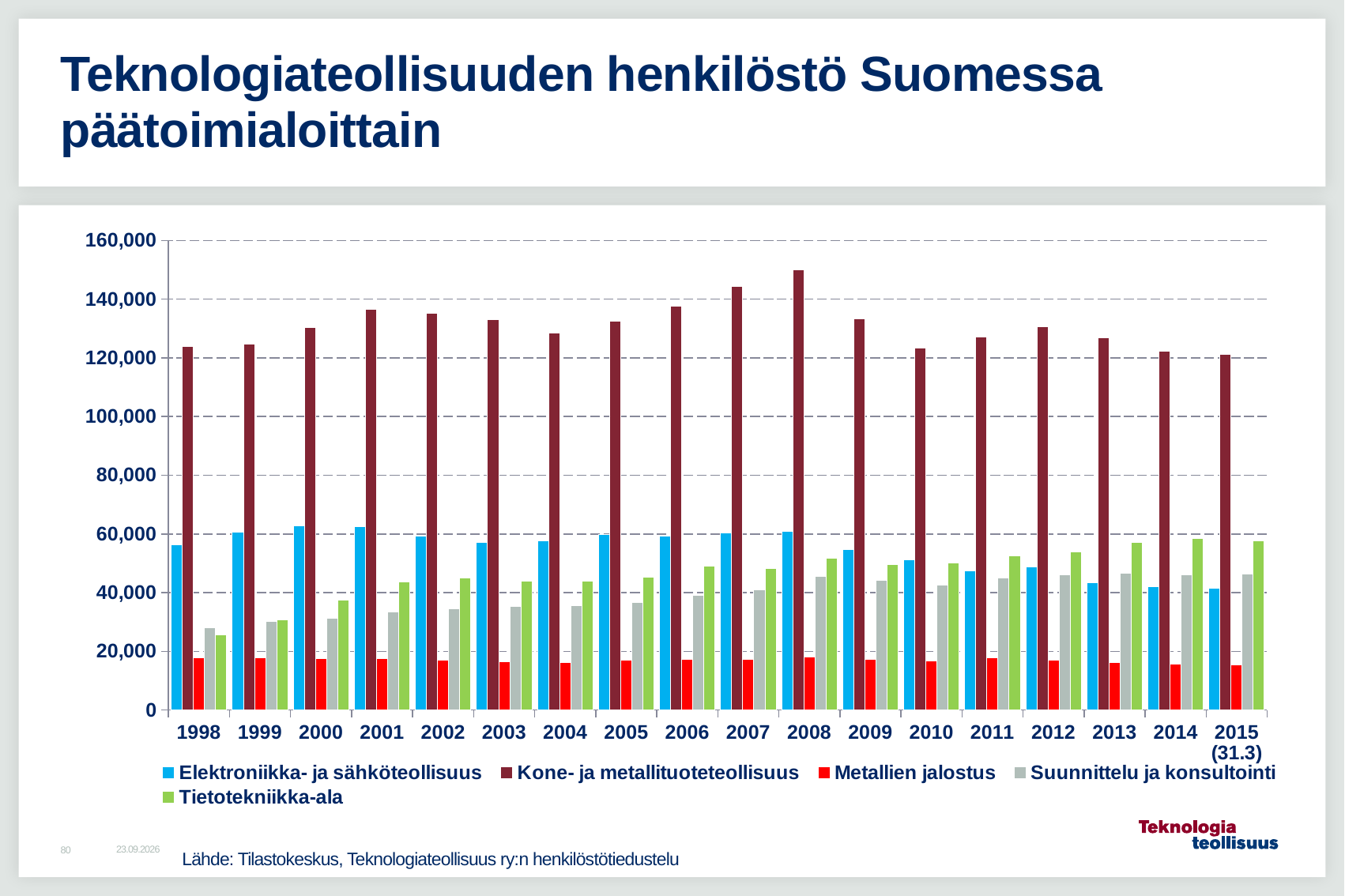
Is the value for Metallien jalostus in 2008 greater or less than 20,000? less What kind of chart is shown on the slide? Bar chart Which series has the larger value in 2015 (31.3): Elektroniikka- ja sähköteollisuus or Tietotekniikka-ala? Tietotekniikka-ala Does the value for Elektroniikka- ja sähköteollisuus rise or fall from 2008 to 2015 (31.3)? fall Is the value for Kone- ja metallituoteteollisuus in 2008 greater or less than 140,000? greater In which year is the value for Tietotekniikka-ala lowest? 1998 Which is larger: Kone- ja metallituoteteollisuus in 2007 or in 2009? 2007 In which year is the value for Kone- ja metallituoteteollisuus highest? 2008 Is the value for Kone- ja metallituoteteollisuus in 2015 (31.3) greater or less than 140,000? less In which year is the value for Suunnittelu ja konsultointi lowest? 1998 How many series does the legend list? 5 How many years are shown on the x axis? 18